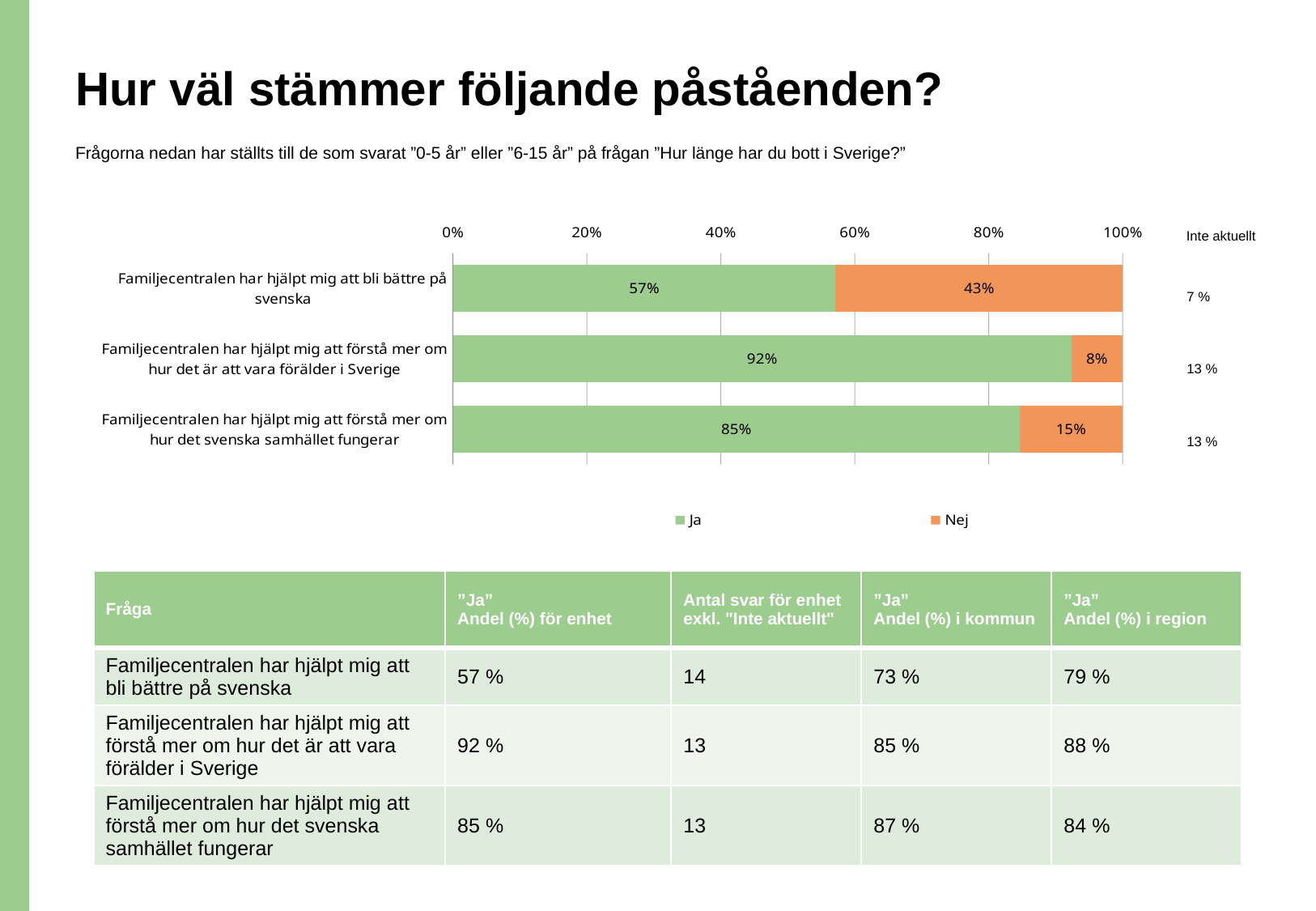
What is the "Ja" value for "Familjecentralen har hjälpt mig att förstå mer om hur det svenska samhället fungerar"? 85% What is the total of the "Ja" and "Nej" values for "Familjecentralen har hjälpt mig att bli bättre på svenska"? 100% What is the "Ja" value for "Familjecentralen har hjälpt mig att bli bättre på svenska"? 57% What kind of chart is shown on the slide? Stacked bar chart How many statements (categories) are shown in the chart? 3 What is the "Nej" value for "Familjecentralen har hjälpt mig att förstå mer om hur det är att vara förälder i Sverige"? 8% How many series does the legend list? 2 Which colour represents "Nej" in the chart? Orange What is the difference between the "Nej" values for "bli bättre på svenska" and "förstå mer om hur det svenska samhället fungerar"? 28% Is the "Ja" value larger for "förstå mer om hur det är att vara förälder i Sverige" or for "förstå mer om hur det svenska samhället fungerar"? förstå mer om hur det är att vara förälder i Sverige Which statement has the lowest "Ja" share? Familjecentralen har hjälpt mig att bli bättre på svenska Which statement has the highest "Ja" share? Familjecentralen har hjälpt mig att förstå mer om hur det är att vara förälder i Sverige